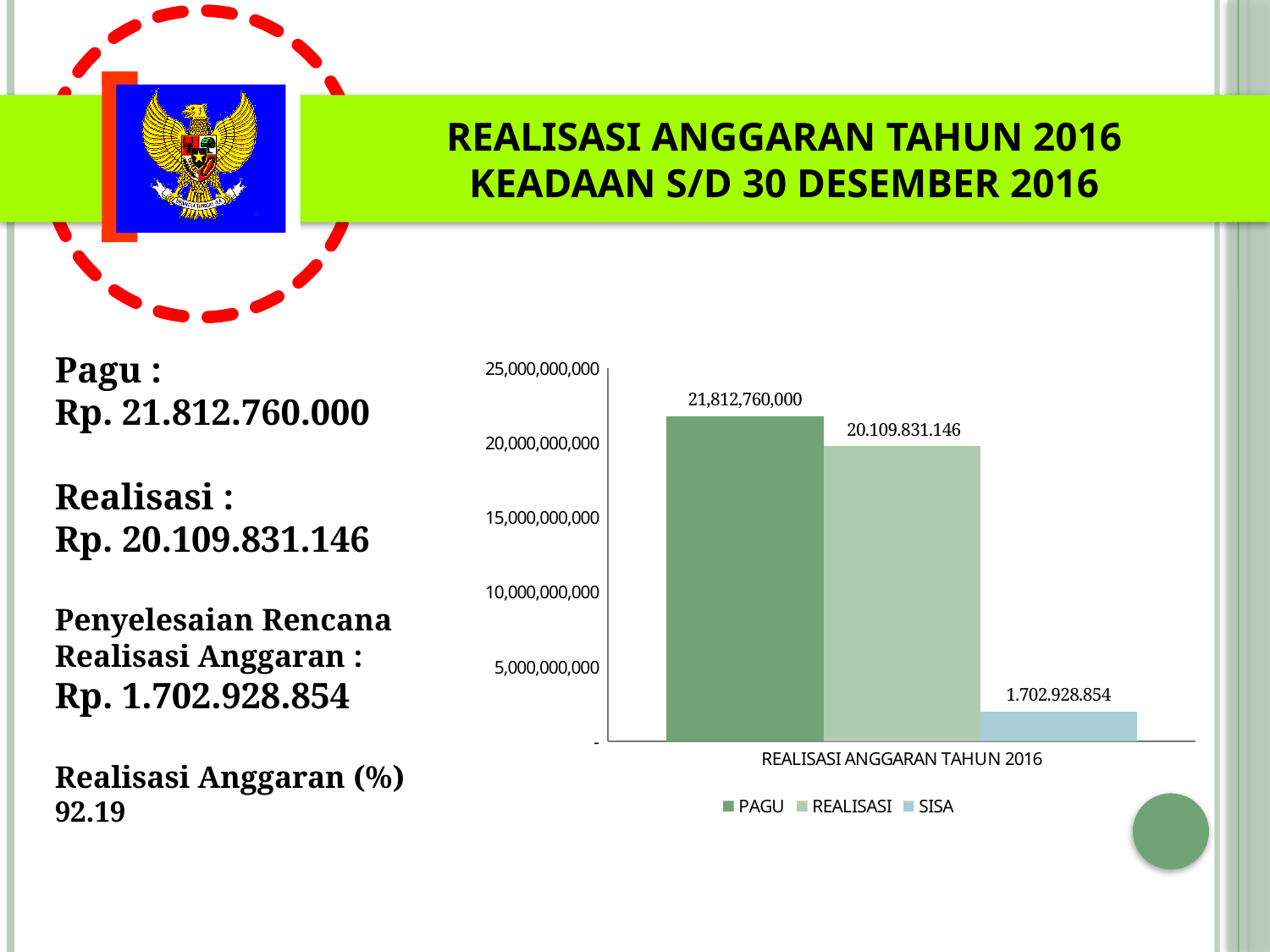
What is the highest value shown on the y axis of the chart? 25,000,000,000 What is the category label shown on the x axis of the chart? REALISASI ANGGARAN TAHUN 2016 What is the value of the PAGU bar? 21,812,760,000 How many series does the legend list? 3 Is the value for PAGU greater or less than 20,000,000,000? greater Is the value for SISA greater or less than 5,000,000,000? less What is the value of the REALISASI bar? 20.109.831.146 Which series has the highest value in the chart? PAGU Which series has the lowest value in the chart? SISA What is the value of the SISA bar? 1.702.928.854 What type of chart is shown on the slide? bar chart Which is larger, the PAGU bar or the REALISASI bar? PAGU